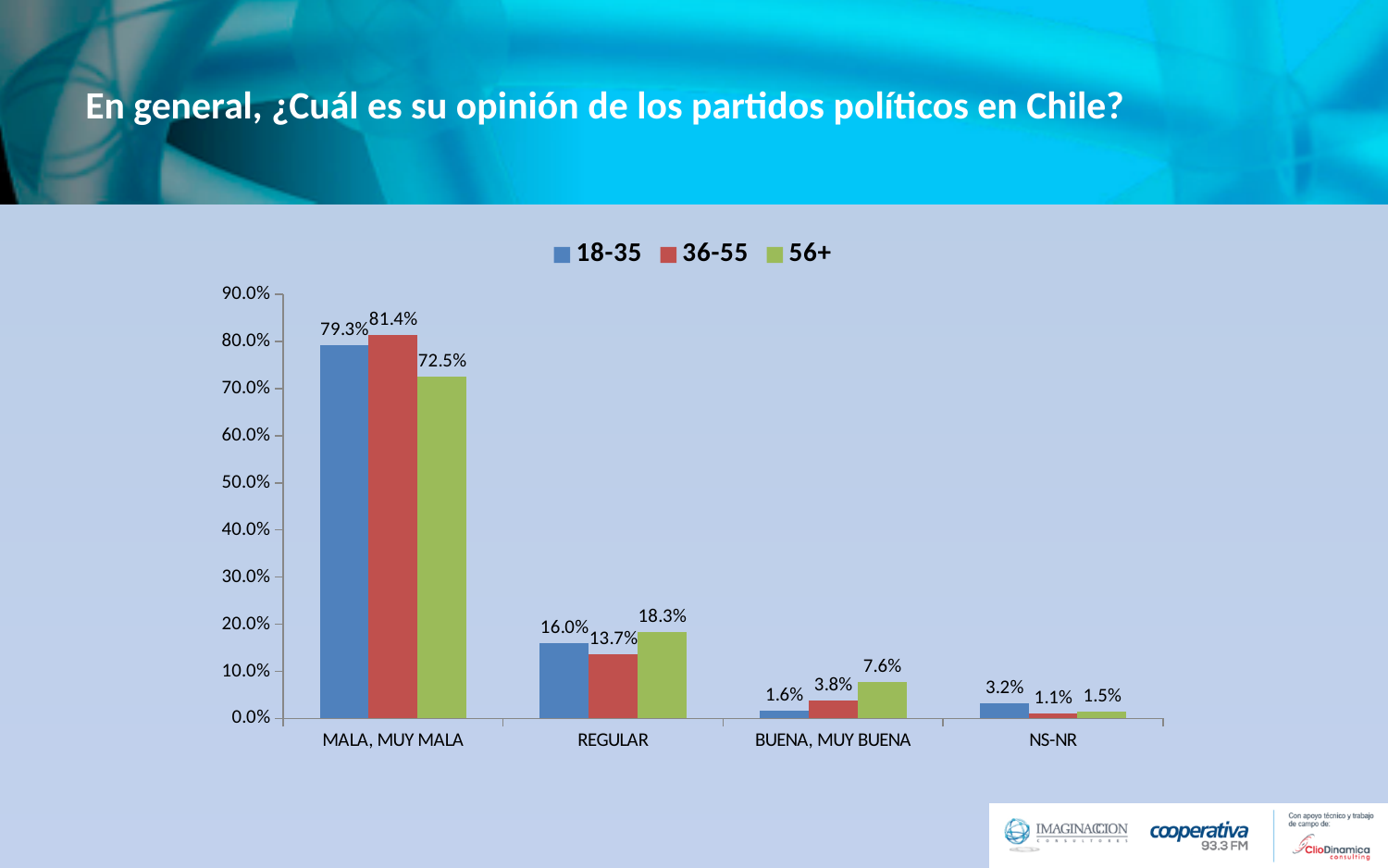
How many series does the legend list? 3 How many categories are shown on the x axis? 4 What kind of chart is shown on the slide? Bar chart Which age group has the highest value in the MALA, MUY MALA category? 36-55 Which colour represents the 56+ series in the legend? Green What is the value for the 36-55 series in the MALA, MUY MALA category? 81.4% What is the value for the 36-55 series in the NS-NR category? 1.1% Which is larger in the REGULAR category: the 18-35 value or the 36-55 value? 18-35 What is the value for the 56+ series in the REGULAR category? 18.3% What is the value for the 18-35 series in the BUENA, MUY BUENA category? 1.6% What is the difference between the 36-55 and 56+ values in the MALA, MUY MALA category? 8.9% Which age group has the lowest value in the BUENA, MUY BUENA category? 18-35